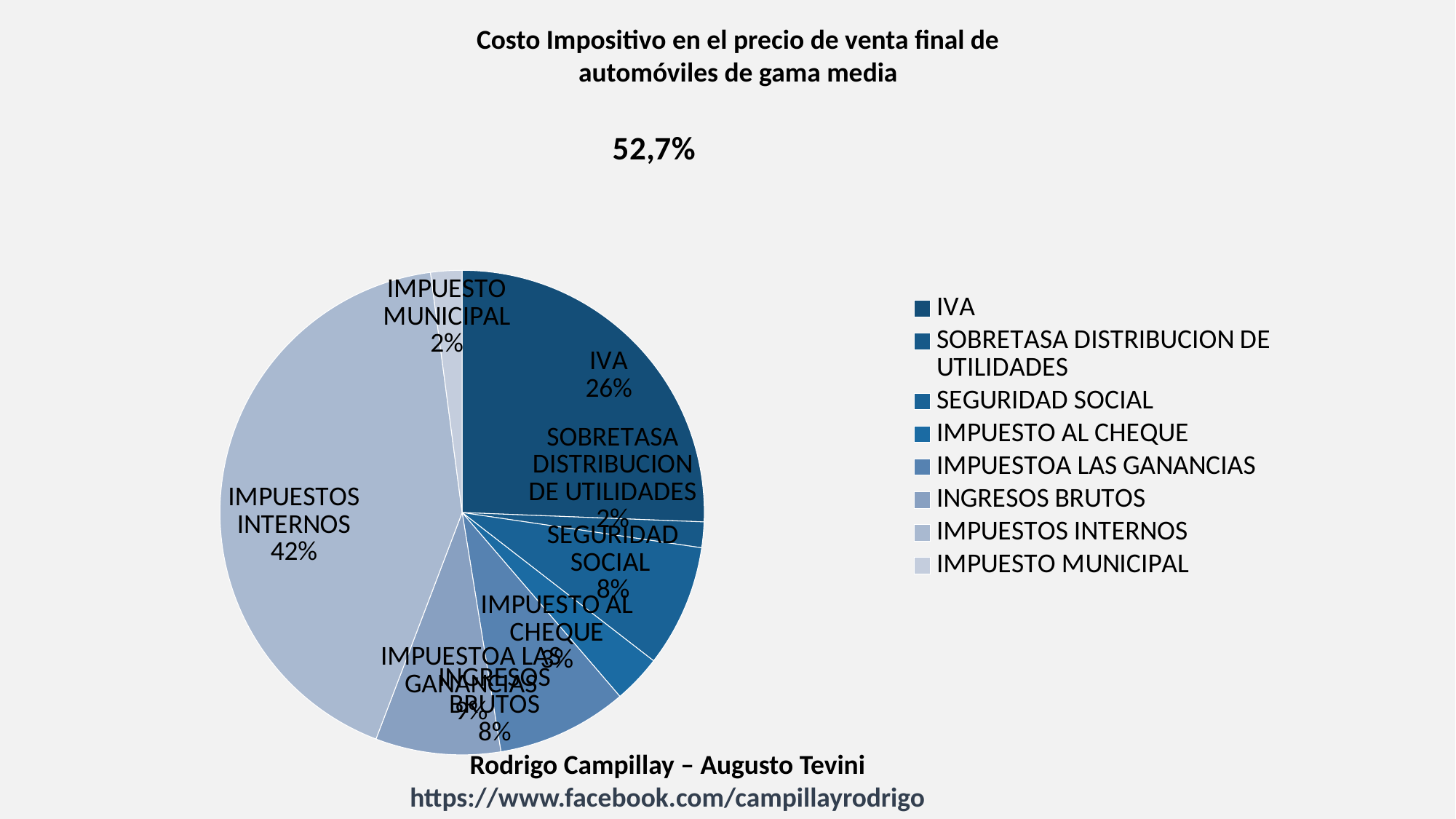
What share of the pie does IMPUESTOS INTERNOS represent? 42% What share of the pie does IMPUESTO MUNICIPAL represent? 2% What is the title of the chart? 52,7% What type of chart is shown on the slide? pie chart Which category has the largest slice of the pie? IMPUESTOS INTERNOS How many slices does the pie chart have? 8 What is the difference in percentage points between IMPUESTOS INTERNOS and IVA? 16 What share of the pie does SEGURIDAD SOCIAL represent? 8% What share of the pie does IVA represent? 26% How many categories does the legend list? 8 Which is larger, the slice for IVA or the slice for SEGURIDAD SOCIAL? IVA What share of the pie does SOBRETASA DISTRIBUCION DE UTILIDADES represent? 2%